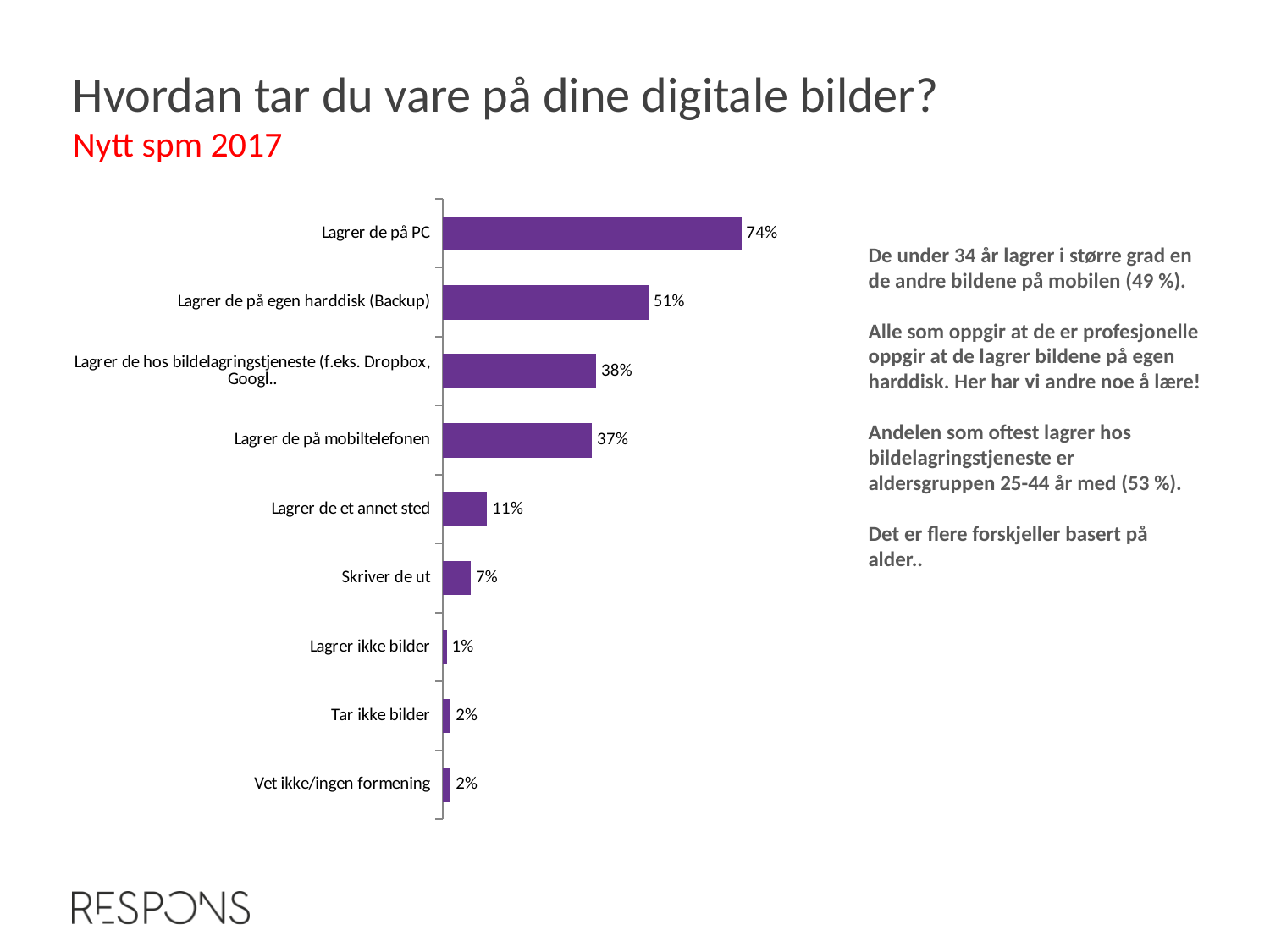
How many categories are shown in the chart? 9 What colour are the bars in the chart? Purple What is the difference between "Lagrer de på PC" and "Lagrer de på egen harddisk (Backup)"? 23% What is the value for "Lagrer de på egen harddisk (Backup)"? 51% What is the value for "Lagrer de på mobiltelefonen"? 37% Which category has the lowest value? Lagrer ikke bilder What is the difference between "Lagrer de et annet sted" and "Skriver de ut"? 4% What kind of chart is shown on the slide? Bar chart Which is larger: "Lagrer de hos bildelagringstjeneste (f.eks. Dropbox, Googl.." or "Lagrer de på mobiltelefonen"? Lagrer de hos bildelagringstjeneste (f.eks. Dropbox, Googl.. Which category has the highest value? Lagrer de på PC What is the value for "Lagrer de på PC"? 74% What is the value for "Skriver de ut"? 7%